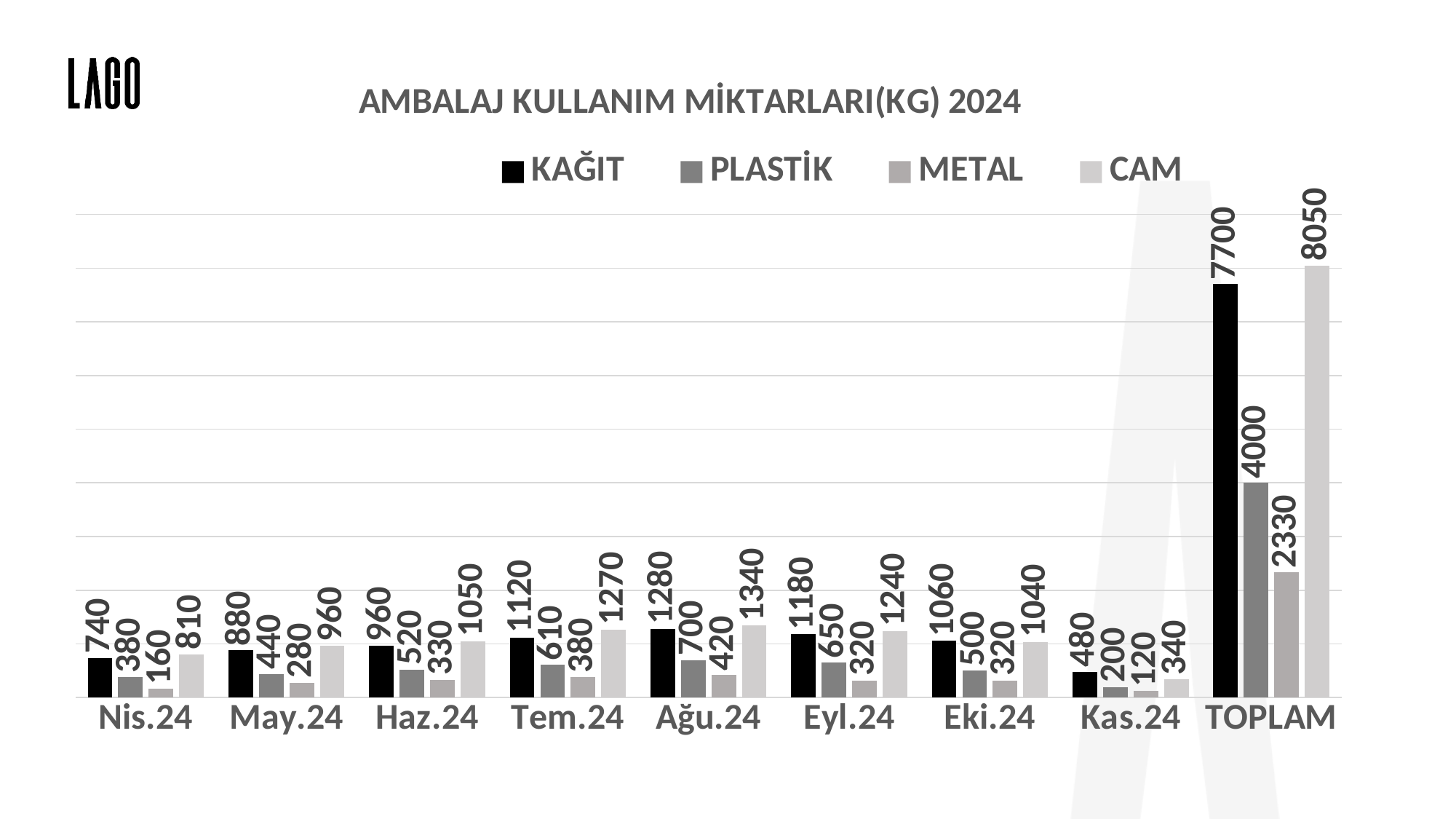
What is the PLASTİK value for TOPLAM? 4000 How many categories are shown on the x axis? 9 What is the METAL value for Kas.24? 120 What is the title of the chart? AMBALAJ KULLANIM MİKTARLARI(KG) 2024 What is the KAĞIT value for Ağu.24? 1280 Which is larger for Eki.24, KAĞIT or CAM? KAĞIT What is the difference between the CAM and KAĞIT values for TOPLAM? 350 How many series does the legend list? 4 What kind of chart is shown on the slide? Bar chart Excluding TOPLAM, which month has the highest CAM value? Ağu.24 What is the CAM value for Tem.24? 1270 Excluding TOPLAM, which month has the lowest KAĞIT value? Kas.24